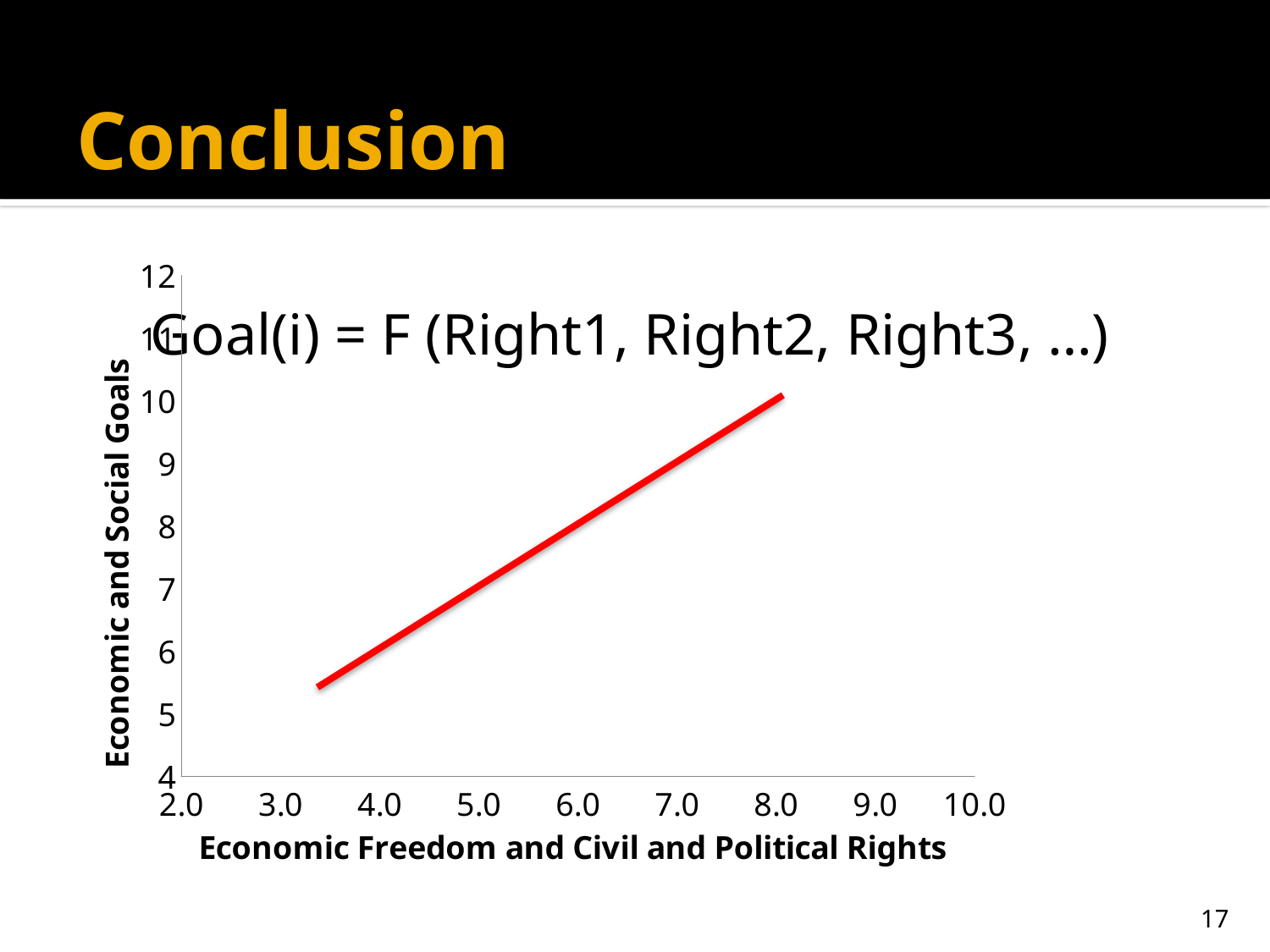
Is the value of the red line at x = 8.0 greater or less than 9? greater Is the value at the right end of the red line greater or less than 9? greater What is the title of the y axis? Economic and Social Goals Which is larger, the value of the red line at x = 4.0 or at x = 7.0? x = 7.0 Is the value of the red line at x = 4.0 greater or less than 7? less Do the values of the red line rise or fall as the x axis increases? rise What kind of chart is shown on the slide? line chart What is the title of the x axis? Economic Freedom and Civil and Political Rights